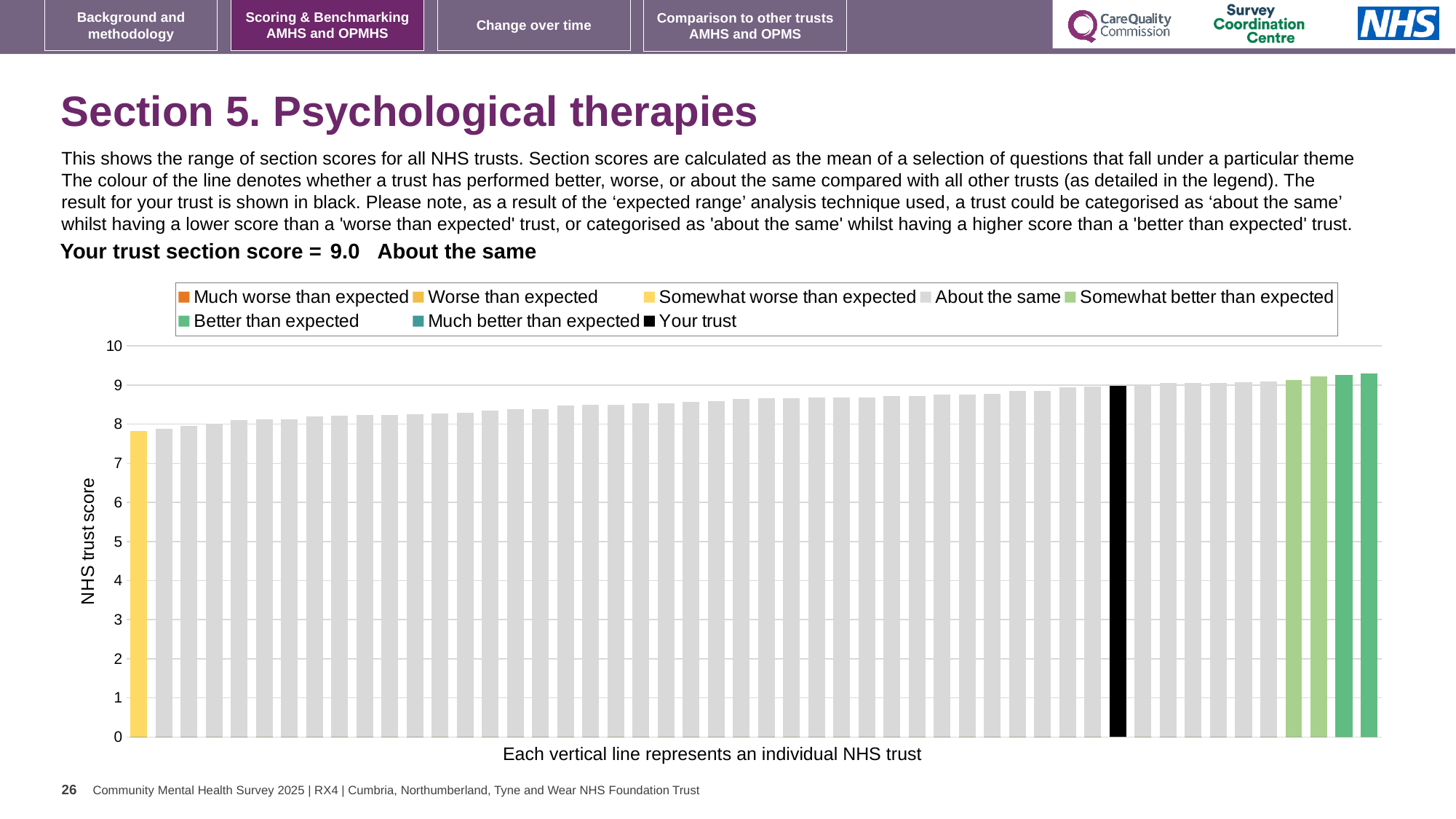
What is the section score for your trust shown on the slide? 9.0 Which bar is the highest in the chart? the rightmost bar How many entries does the chart legend list? 8 Is the value of the leftmost bar greater or less than 8? less What kind of chart is shown on the slide? bar chart Is the value of the rightmost bar greater or less than 10? less Which is larger, the value of the black 'Your trust' bar or the value of the leftmost bar? the black 'Your trust' bar Is the value of the leftmost bar greater or less than 7? greater Do the bar values rise or fall from left to right across the chart? rise Which bar is the lowest in the chart? the leftmost bar Which category is your trust placed in for this section? About the same What is the label on the vertical axis of the chart? NHS trust score